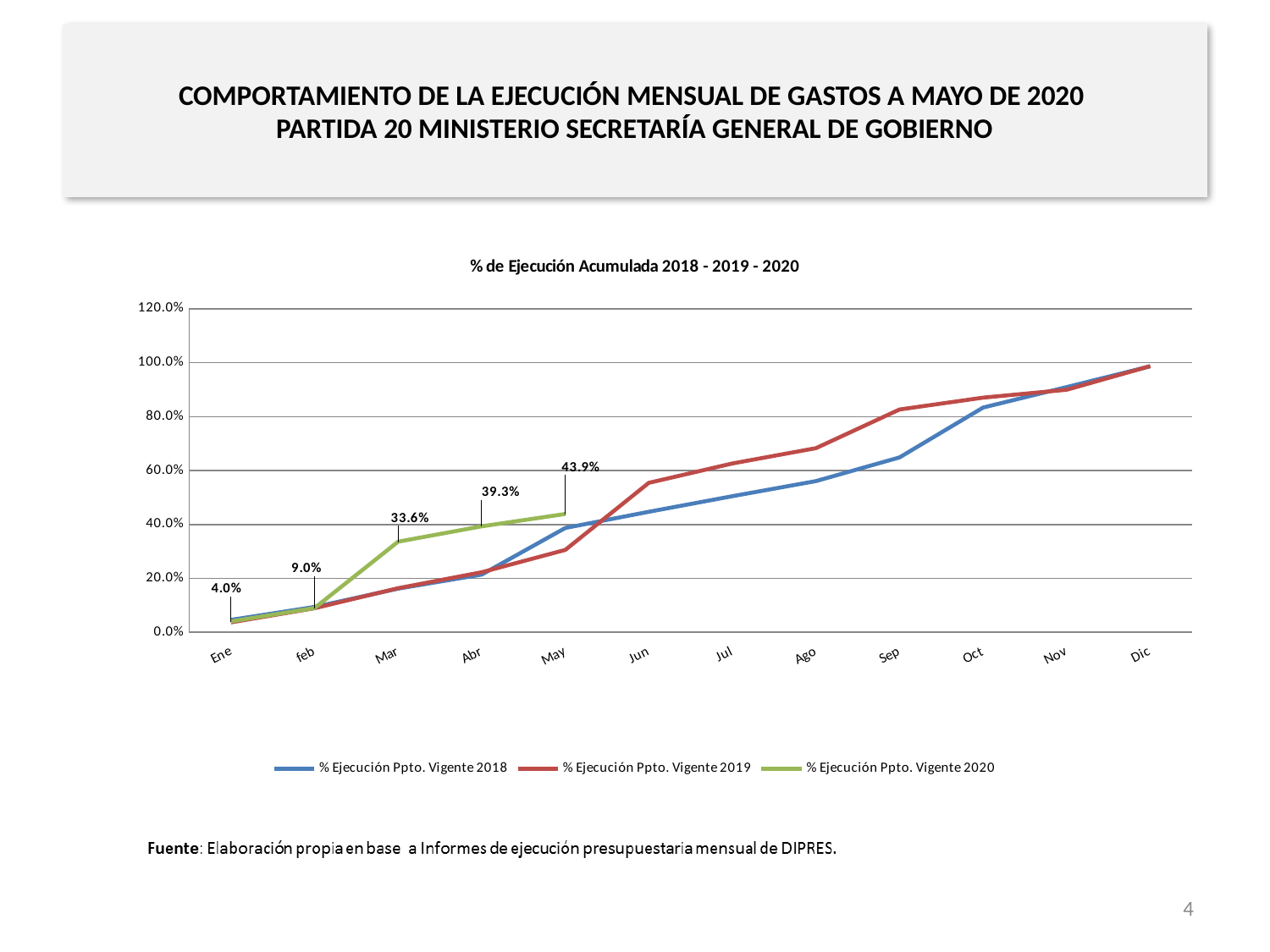
Is the value for % Ejecución Ppto. Vigente 2018 in Sep greater or less than 80.0%? less How many months are shown on the x axis? 12 What is the value of % Ejecución Ppto. Vigente 2020 in Ene? 4.0% What is the title of the chart? % de Ejecución Acumulada 2018 - 2019 - 2020 Which month has the highest labelled value for the 2020 series? May What is the value of % Ejecución Ppto. Vigente 2020 in May? 43.9% What kind of chart is shown on the slide? Line chart In Sep, which series is higher: % Ejecución Ppto. Vigente 2018 or % Ejecución Ppto. Vigente 2019? % Ejecución Ppto. Vigente 2019 What is the value of % Ejecución Ppto. Vigente 2020 in Mar? 33.6% How many series does the legend list? 3 By how many percentage points does the 2020 series increase from Abr to May? 4.6 By how many percentage points does the 2020 series increase from feb to Mar? 24.6